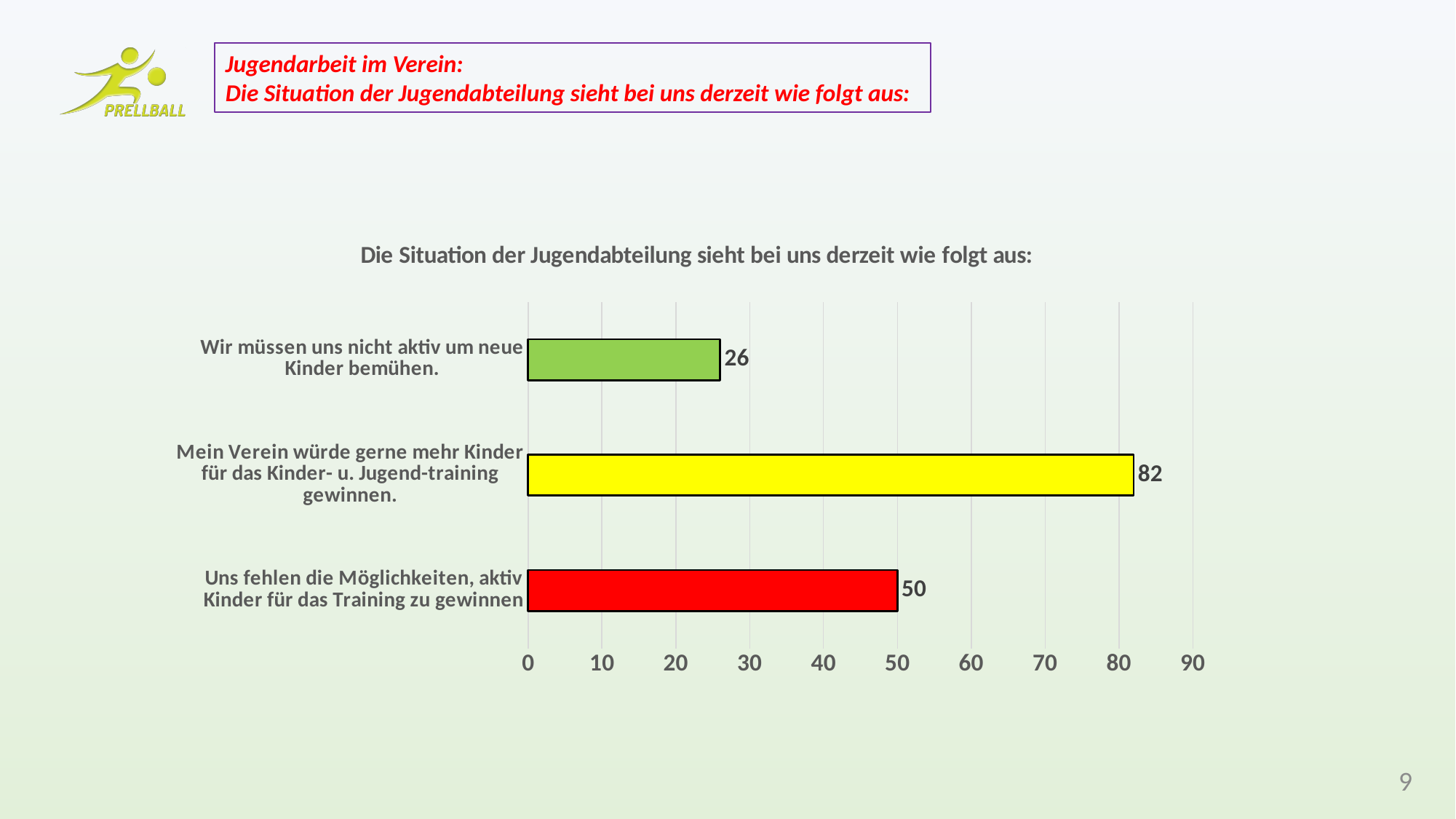
Which is larger: the value for "Uns fehlen die Möglichkeiten, aktiv Kinder für das Training zu gewinnen" or the value for "Wir müssen uns nicht aktiv um neue Kinder bemühen."? Uns fehlen die Möglichkeiten, aktiv Kinder für das Training zu gewinnen Which category has the lowest value? Wir müssen uns nicht aktiv um neue Kinder bemühen. What kind of chart is shown on the slide? bar chart Is the value for "Mein Verein würde gerne mehr Kinder für das Kinder- u. Jugend-training gewinnen." greater or less than 70? greater Which category has the highest value? Mein Verein würde gerne mehr Kinder für das Kinder- u. Jugend-training gewinnen. What is the difference between the values for "Mein Verein würde gerne mehr Kinder für das Kinder- u. Jugend-training gewinnen." and "Uns fehlen die Möglichkeiten, aktiv Kinder für das Training zu gewinnen"? 32 What is the difference between the values for "Uns fehlen die Möglichkeiten, aktiv Kinder für das Training zu gewinnen" and "Wir müssen uns nicht aktiv um neue Kinder bemühen."? 24 What is the value for "Mein Verein würde gerne mehr Kinder für das Kinder- u. Jugend-training gewinnen."? 82 What is the value for "Uns fehlen die Möglichkeiten, aktiv Kinder für das Training zu gewinnen"? 50 What is the value for "Wir müssen uns nicht aktiv um neue Kinder bemühen."? 26 What colour is the bar for "Mein Verein würde gerne mehr Kinder für das Kinder- u. Jugend-training gewinnen."? yellow How many categories are shown in the chart? 3